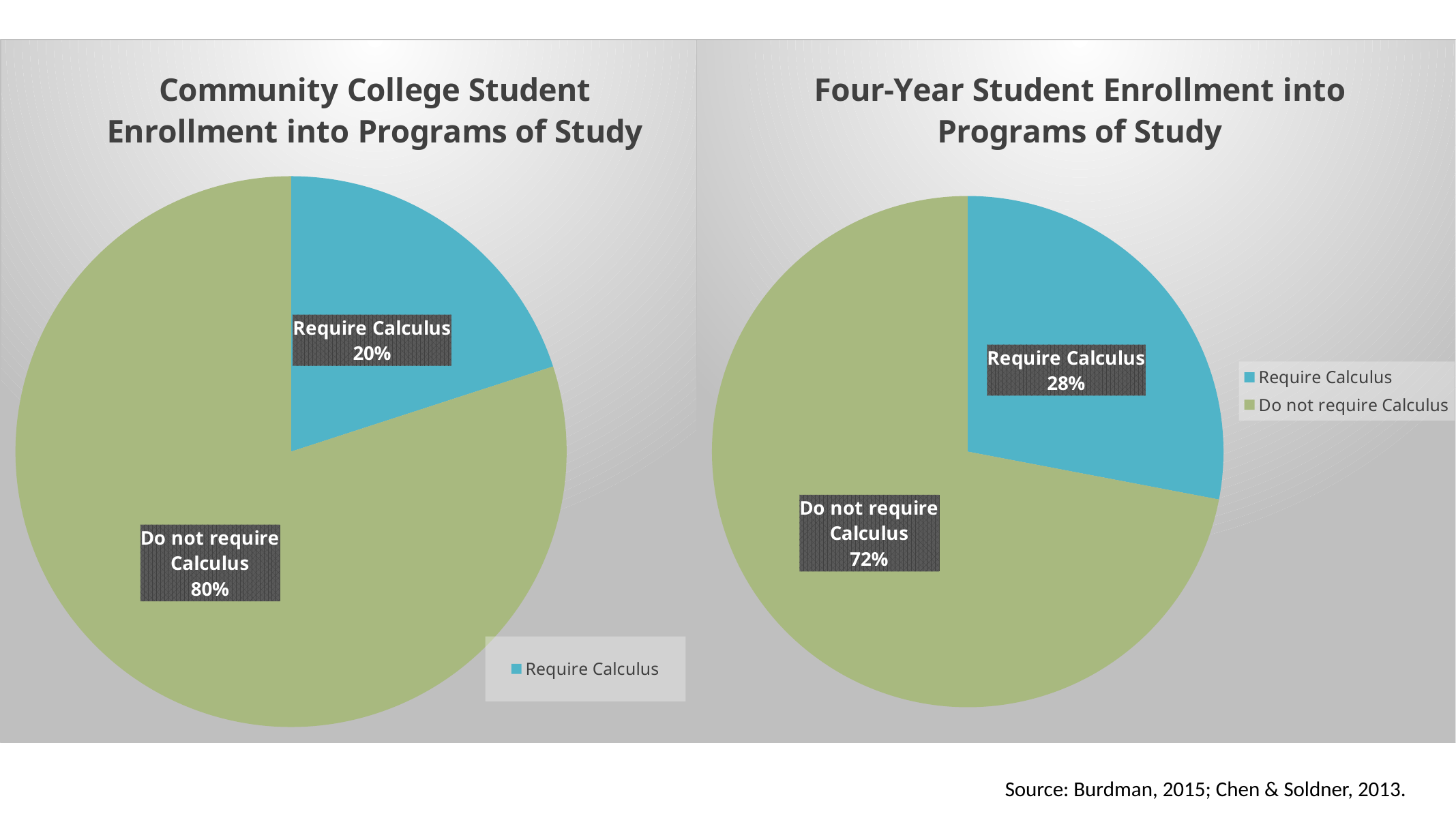
In the 'Four-Year Student Enrollment into Programs of Study' chart, what share of students enroll in programs that require calculus? 28% How many slices does the 'Four-Year Student Enrollment into Programs of Study' pie chart have? 2 In the 'Four-Year Student Enrollment into Programs of Study' chart, which slice is the largest? Do not require Calculus In the 'Four-Year Student Enrollment into Programs of Study' chart, what is the difference between the 'Do not require Calculus' and 'Require Calculus' shares? 44 percentage points In the 'Community College Student Enrollment into Programs of Study' chart, which slice is the smallest? Require Calculus In the 'Community College Student Enrollment into Programs of Study' chart, what is the difference between the 'Do not require Calculus' and 'Require Calculus' shares? 60 percentage points In the 'Community College Student Enrollment into Programs of Study' chart, what share of students enroll in programs that require calculus? 20% Which chart shows a larger 'Require Calculus' share, the Community College chart or the Four-Year chart? Four-Year Student Enrollment into Programs of Study What kind of chart is the 'Community College Student Enrollment into Programs of Study' chart? Pie chart In the 'Four-Year Student Enrollment into Programs of Study' chart, what share of students enroll in programs that do not require calculus? 72% In the 'Community College Student Enrollment into Programs of Study' chart, what share of students enroll in programs that do not require calculus? 80% How many entries does the legend of the 'Four-Year Student Enrollment into Programs of Study' chart list? 2